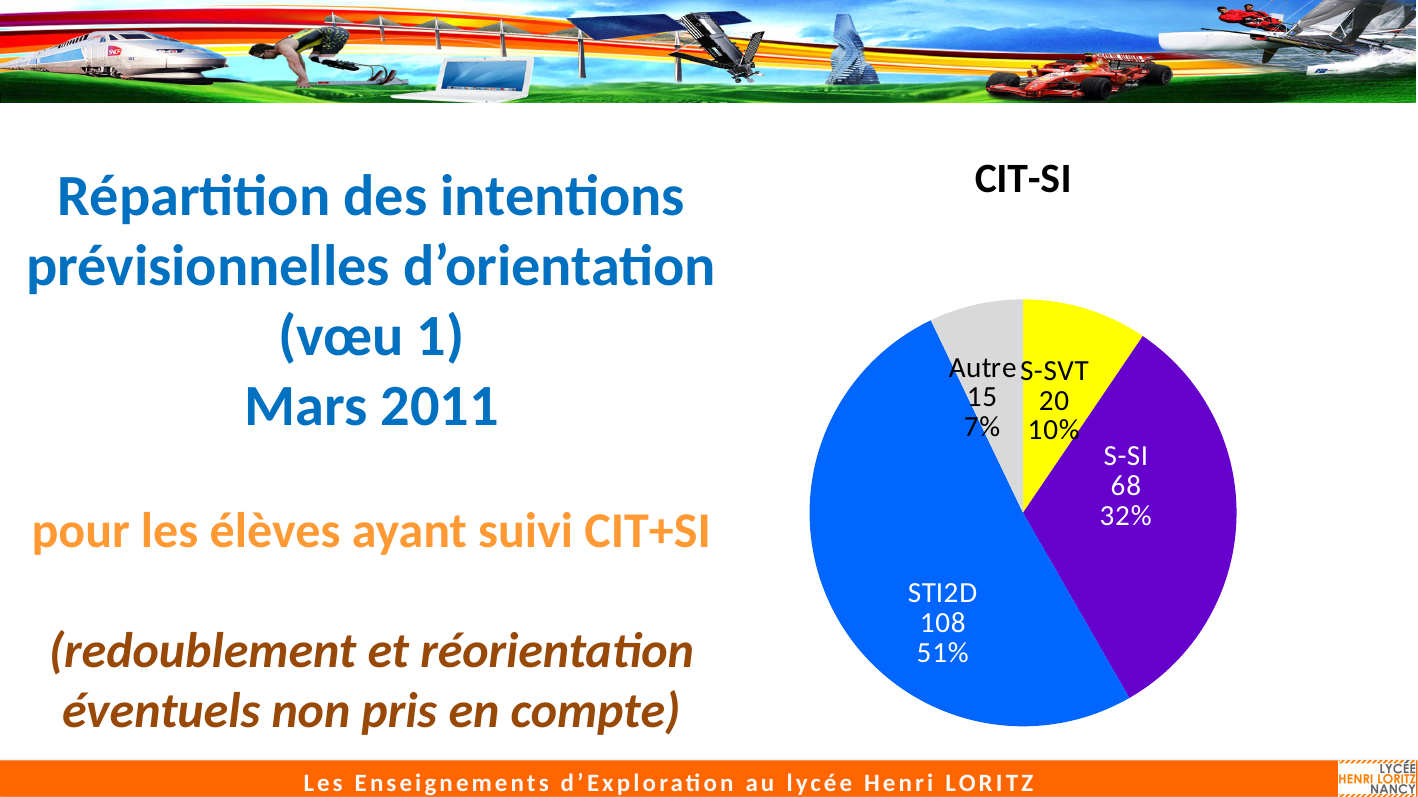
What is the value for Autre? 15 What type of chart is shown on the slide? pie chart What is the title of the chart? CIT-SI What percentage share of the pie does STI2D represent? 51% What is the difference between the values for STI2D and S-SI? 40 What is the value for S-SVT? 20 What percentage share of the pie does S-SI represent? 32% What is the value for STI2D? 108 How many slices does the pie chart have? 4 Which category has the largest slice? STI2D What is the value for S-SI? 68 Which category has the smallest slice? Autre